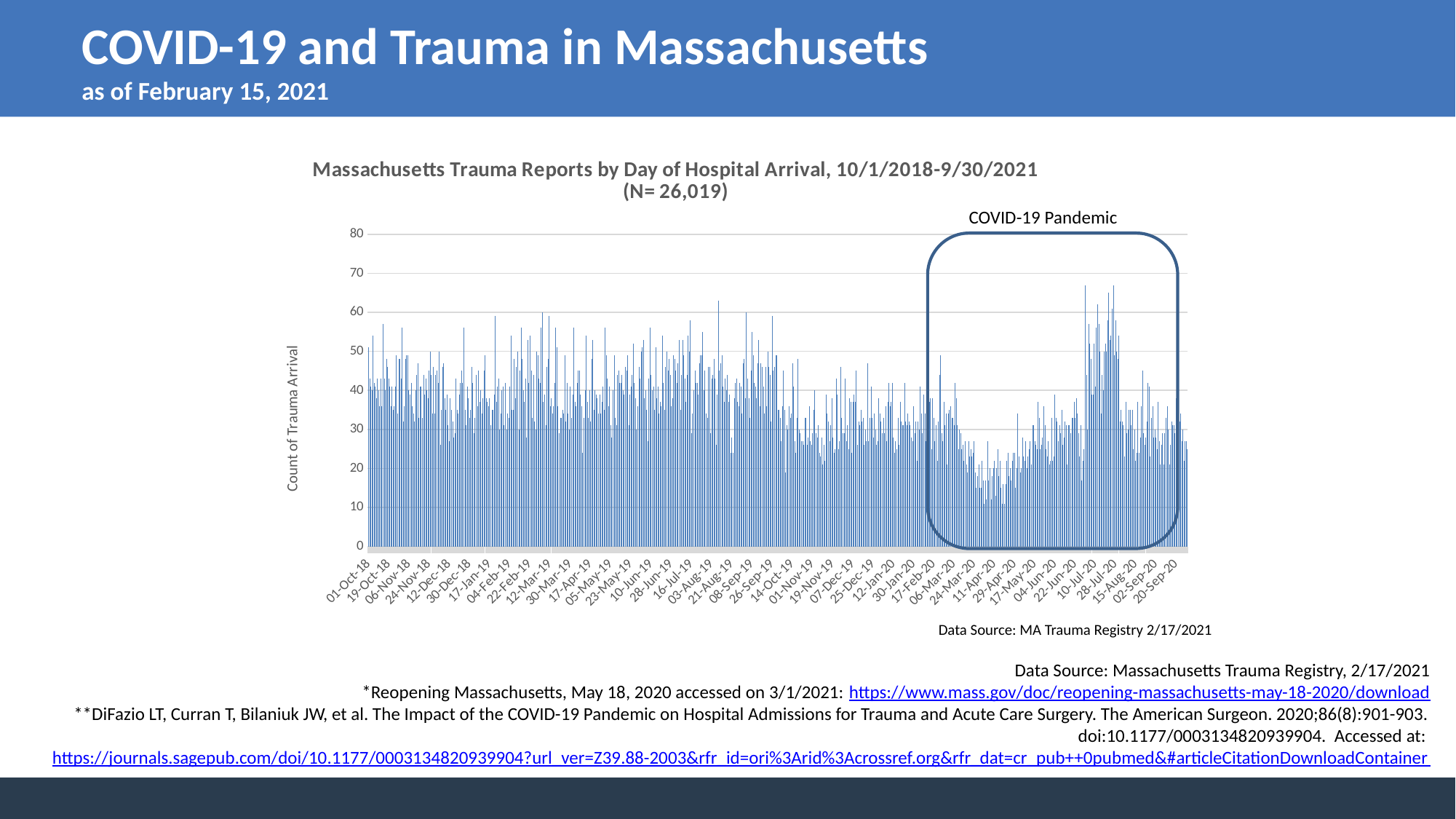
Is the daily count for 11-Apr-20 greater or less than 40? less What is the title of the chart? Massachusetts Trauma Reports by Day of Hospital Arrival, 10/1/2018-9/30/2021 (N= 26,019) Does any bar on the chart reach the 70 gridline? No What kind of chart is shown on the slide? bar chart What total N is printed in the chart title? 26,019 Between 17-Feb-20 and 11-Apr-20, do the daily trauma counts generally rise or fall? fall Are the tallest bars in the late July 2020 period greater or less than 60? greater What label is written above the boxed region on the right side of the chart? COVID-19 Pandemic Between 11-Apr-20 and 10-Jul-20, do the daily trauma counts generally rise or fall? rise